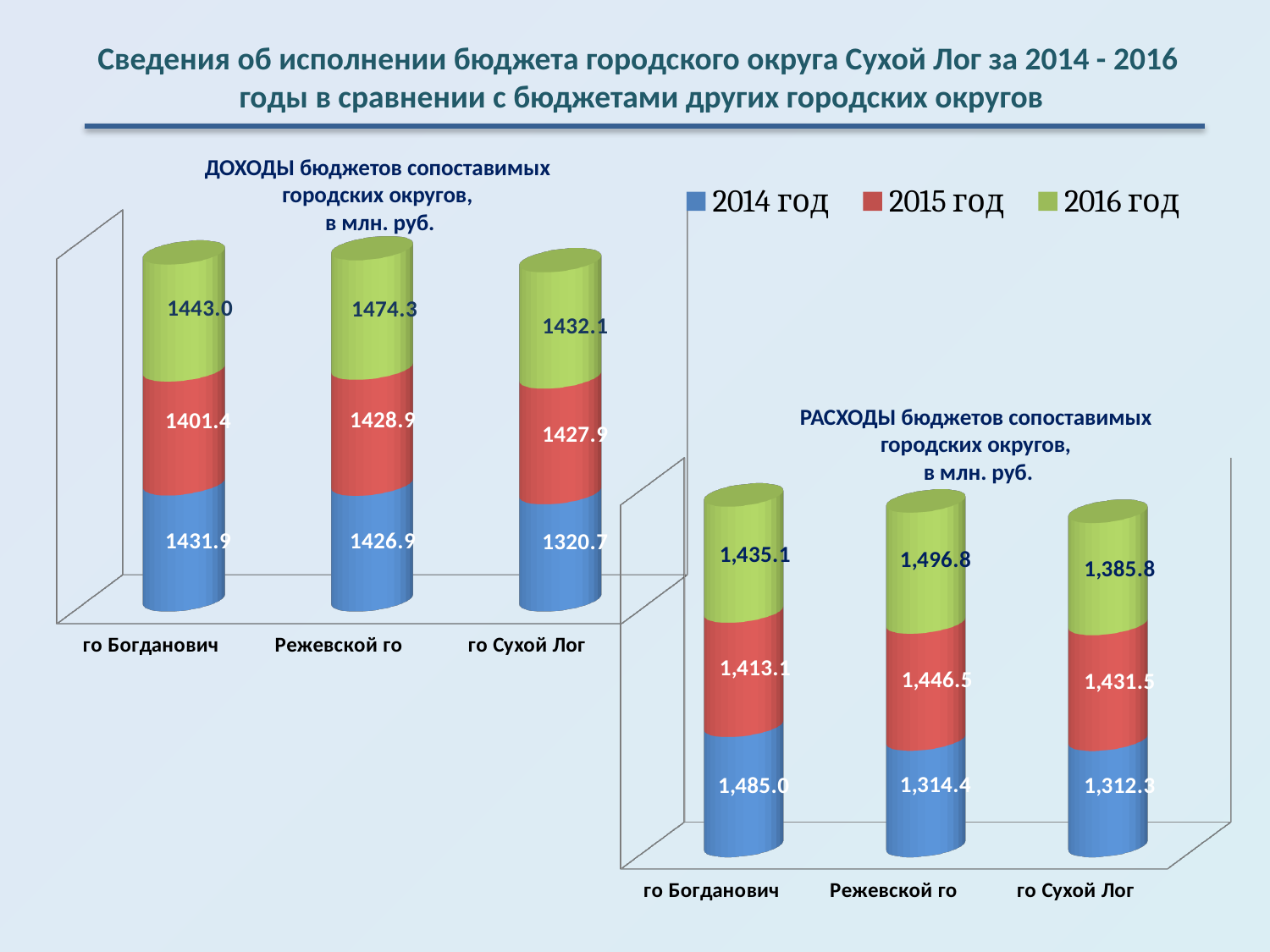
What kind of chart is the ДОХОДЫ (revenues) chart? Stacked bar chart In the ДОХОДЫ (revenues) chart, what is the value for го Сухой Лог in 2014 год? 1320.7 In the ДОХОДЫ (revenues) chart, which district has the highest value for 2016 год? Режевской го In the ДОХОДЫ (revenues) chart, what is the difference between the 2016 год values for Режевской го and го Богданович? 31.3 In the РАСХОДЫ (expenditures) chart, what is the total of the stacked bar for го Сухой Лог? 4,129.6 In the ДОХОДЫ (revenues) chart, what is the value for Режевской го in 2016 год? 1474.3 In the РАСХОДЫ (expenditures) chart, what is the value for го Богданович in 2014 год? 1,485.0 In the ДОХОДЫ (revenues) chart, which district has the lowest value for 2014 год? го Сухой Лог In the РАСХОДЫ (expenditures) chart, which district has the highest value for 2016 год? Режевской го In the РАСХОДЫ (expenditures) chart, is the 2014 год value for го Богданович larger or smaller than the 2014 год value for Режевской го? larger How many series does the legend list? 3 In the РАСХОДЫ (expenditures) chart, what is the value for го Сухой Лог in 2015 год? 1,431.5